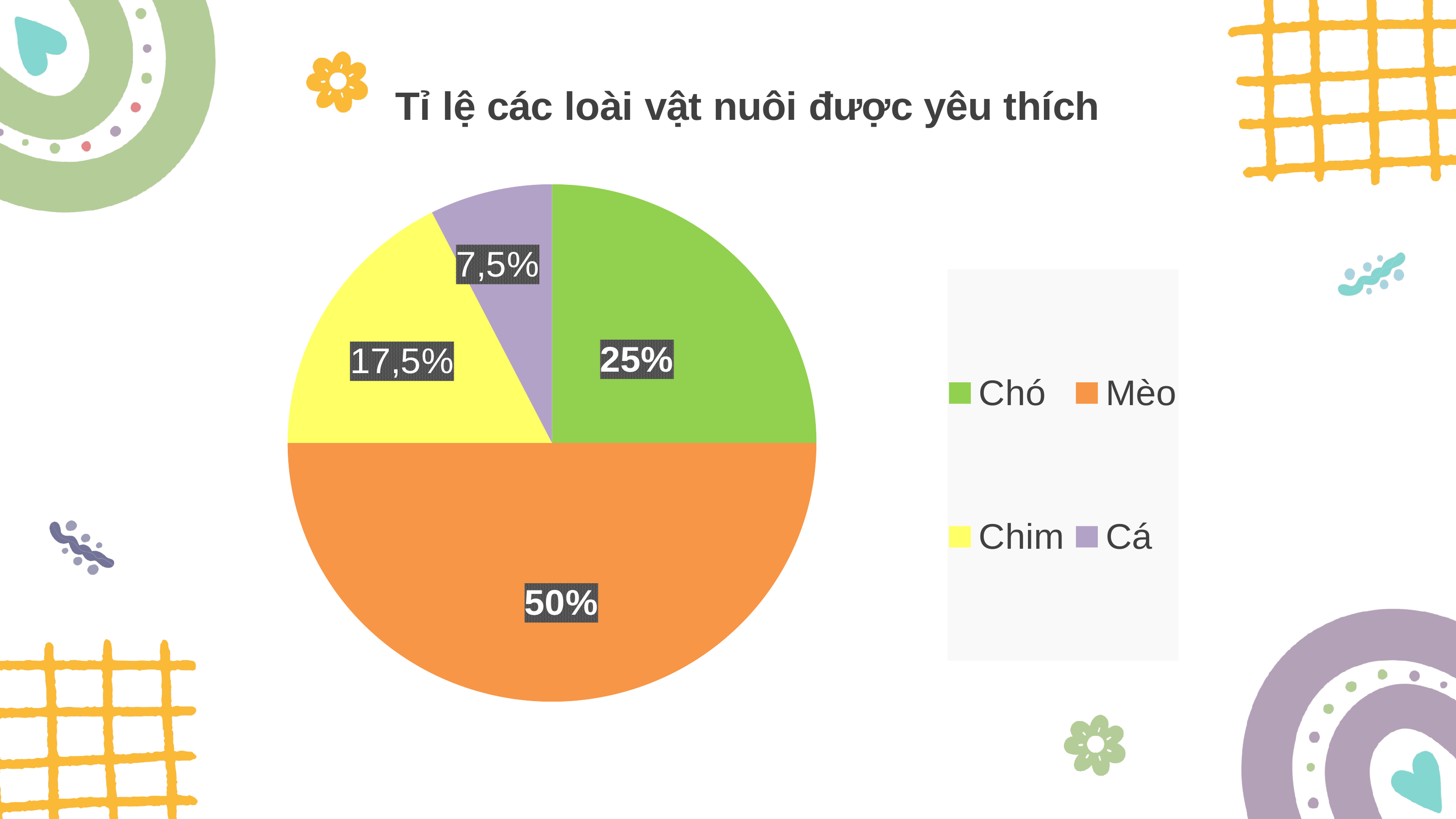
Which is larger, the share of Chó or the share of Chim? Chó What share of the pie does Chó have? 25% What share of the pie does Cá have? 7,5% What is the title of the chart? Tỉ lệ các loài vật nuôi được yêu thích Which category has the largest slice of the pie? Mèo Which category has the smallest slice of the pie? Cá What share of the pie does Chim have? 17,5% What kind of chart is shown on the slide? Pie chart How many categories are shown in the pie chart? 4 What is the difference between the shares of Chim and Cá? 10% What is the difference between the shares of Mèo and Chó? 25%